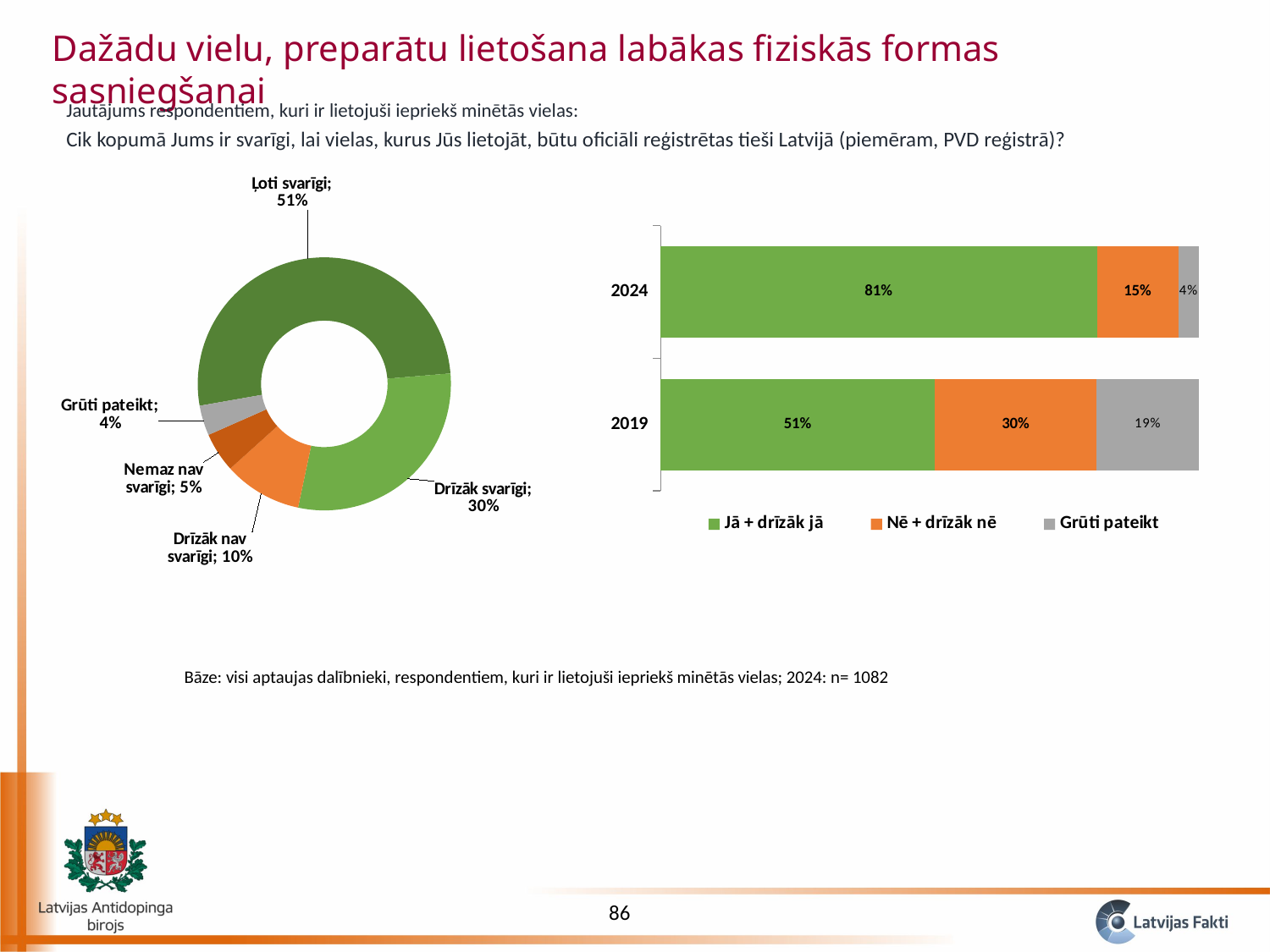
In the doughnut chart on the left, which category has the smallest share? Grūti pateikt In the stacked bar chart on the right, which year has the larger value for "Nē + drīzāk nē"? 2019 In the doughnut chart on the left, what share is labelled "Drīzāk nav svarīgi"? 10% In the doughnut chart on the left, what is the difference between the shares for "Ļoti svarīgi" and "Drīzāk svarīgi"? 21 percentage points In the doughnut chart on the left, how many categories are shown? 5 In the stacked bar chart on the right, what colour represents "Grūti pateikt"? Grey In the stacked bar chart on the right, how many series does the legend list? 3 In the doughnut chart on the left, what share is labelled "Ļoti svarīgi"? 51% In the stacked bar chart on the right, what is the difference in "Jā + drīzāk jā" between 2024 and 2019? 30 percentage points What type of chart is shown on the right side of the slide? Stacked bar chart In the stacked bar chart on the right, what is the value of "Jā + drīzāk jā" for 2024? 81% In the stacked bar chart on the right, what is the value of "Grūti pateikt" for 2019? 19%